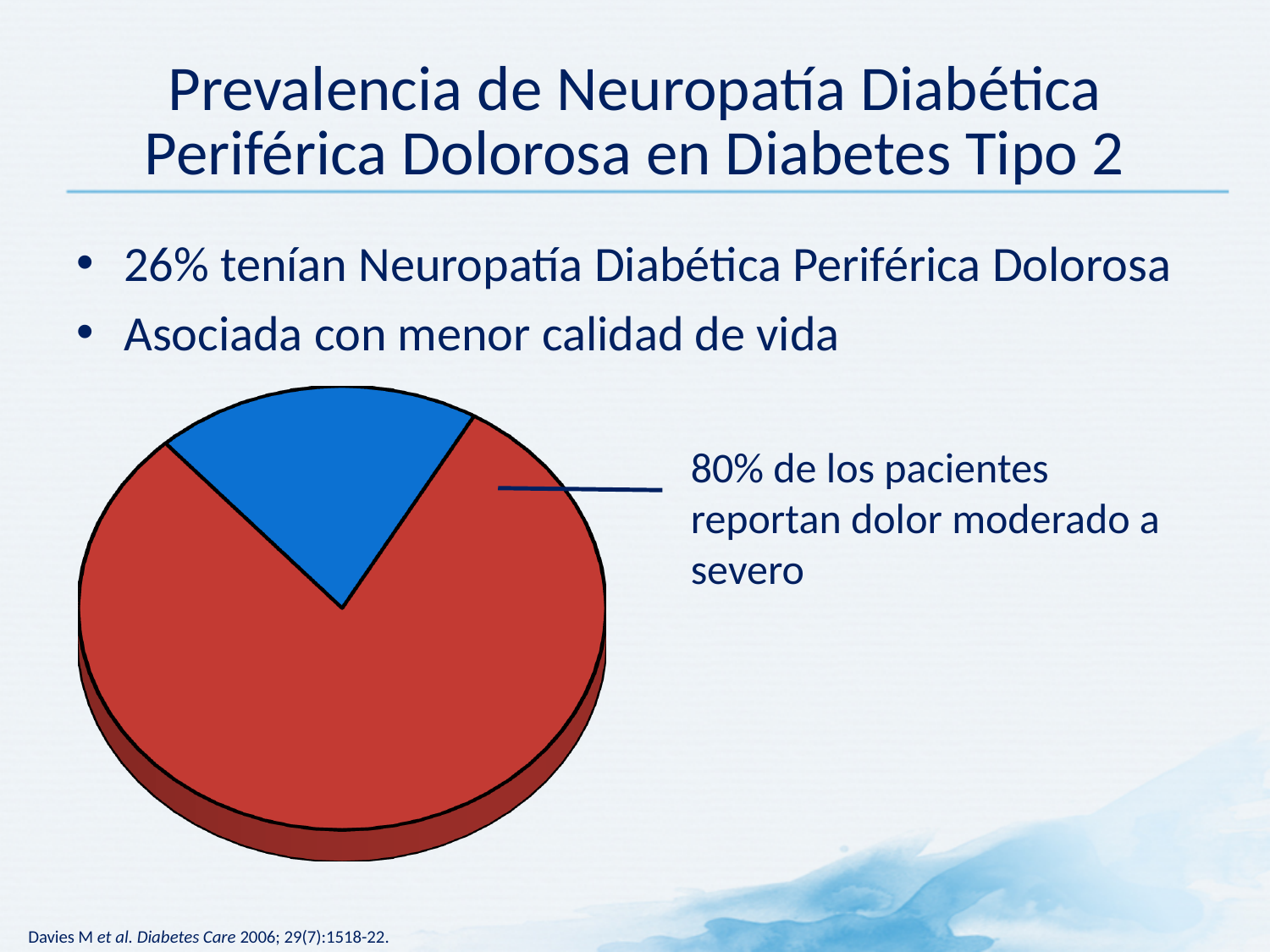
What share of patients does the red slice of the pie chart represent, according to the annotation? 80% What kind of chart is shown on the slide? pie chart What does the annotation next to the pie chart say the red slice represents? 80% de los pacientes reportan dolor moderado a severo Is the blue slice of the pie chart greater or less than 50% of the pie? less How many slices does the pie chart have? 2 Is the red slice or the blue slice of the pie chart larger? the red slice Which slice of the pie chart is the smallest? the blue slice Which slice of the pie chart is the largest? the red slice What colour is the smaller slice of the pie chart? blue Is the red slice of the pie chart greater or less than 50% of the pie? greater